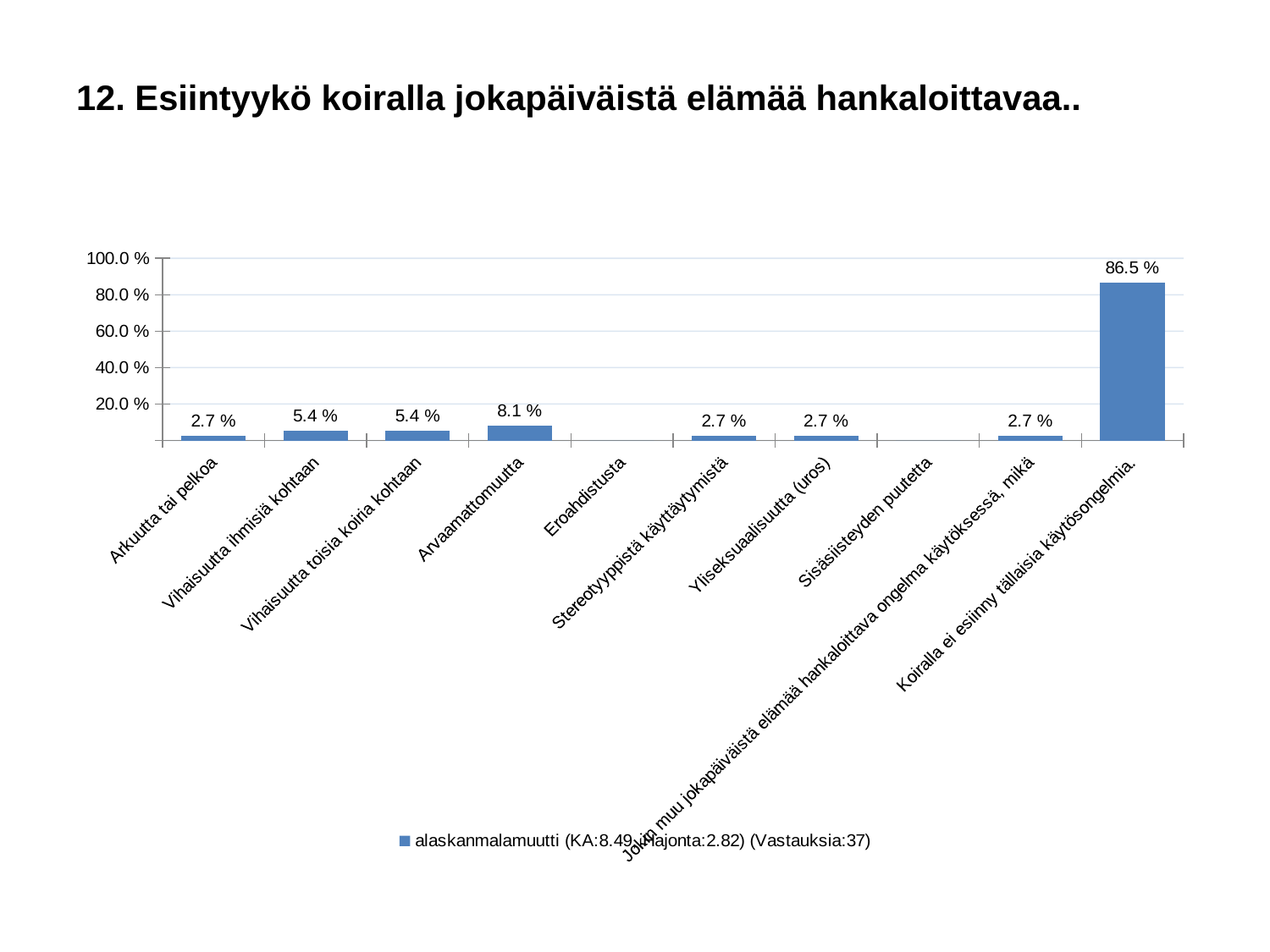
How many series does the legend list? 1 Which is larger, the value for "Arvaamattomuutta" or the value for "Vihaisuutta toisia koiria kohtaan"? Arvaamattomuutta Which category has the highest value? Koiralla ei esiinny tällaisia käytösongelmia. What is the value for "Koiralla ei esiinny tällaisia käytösongelmia."? 86.5 % What is the difference between the values for "Arvaamattomuutta" and "Yliseksuaalisuutta (uros)"? 5.4 % What is the difference between the values for "Koiralla ei esiinny tällaisia käytösongelmia." and "Arvaamattomuutta"? 78.4 % What is the value for "Arvaamattomuutta"? 8.1 % What kind of chart is shown on the slide? Bar chart What is the value for "Arkuutta tai pelkoa"? 2.7 % Is the value for "Koiralla ei esiinny tällaisia käytösongelmia." greater or less than 80.0 %? greater How many categories are shown on the x axis? 10 What is the value for "Vihaisuutta ihmisiä kohtaan"? 5.4 %